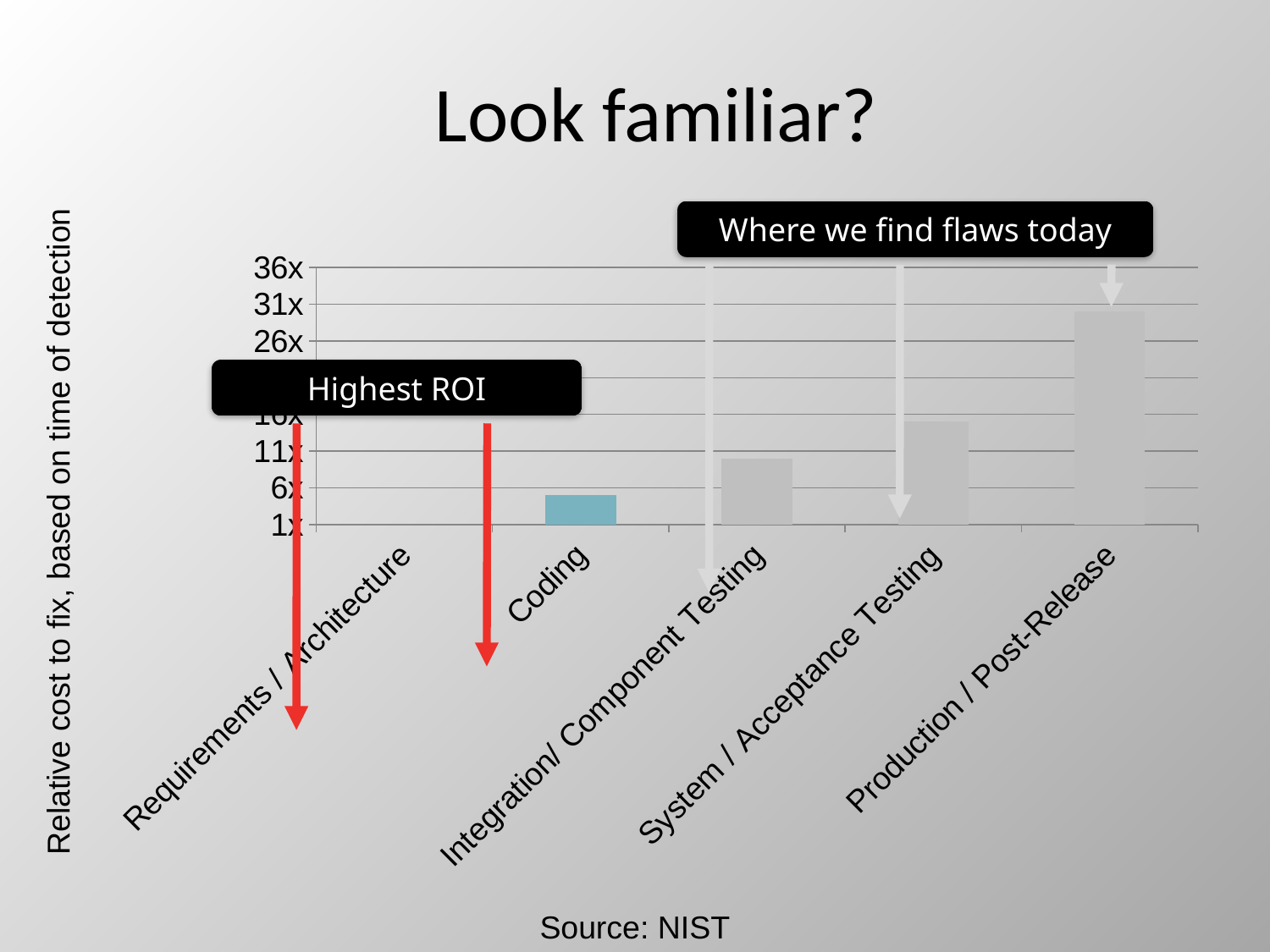
Is the value for Coding greater or less than 6x? less Is the value for Production / Post-Release greater or less than 26x? greater Is the value for System / Acceptance Testing greater or less than 11x? greater Which category has the lowest value in the chart? Requirements / Architecture How many categories are shown on the x axis of the chart? 5 What is the label on the vertical axis of the chart? Relative cost to fix, based on time of detection Which is larger, the value for Production / Post-Release or the value for Coding? Production / Post-Release Do the bar values rise or fall from left to right along the x axis? rise Which category has the highest bar in the chart? Production / Post-Release What source is cited below the chart? NIST What kind of chart is shown on the slide? bar chart